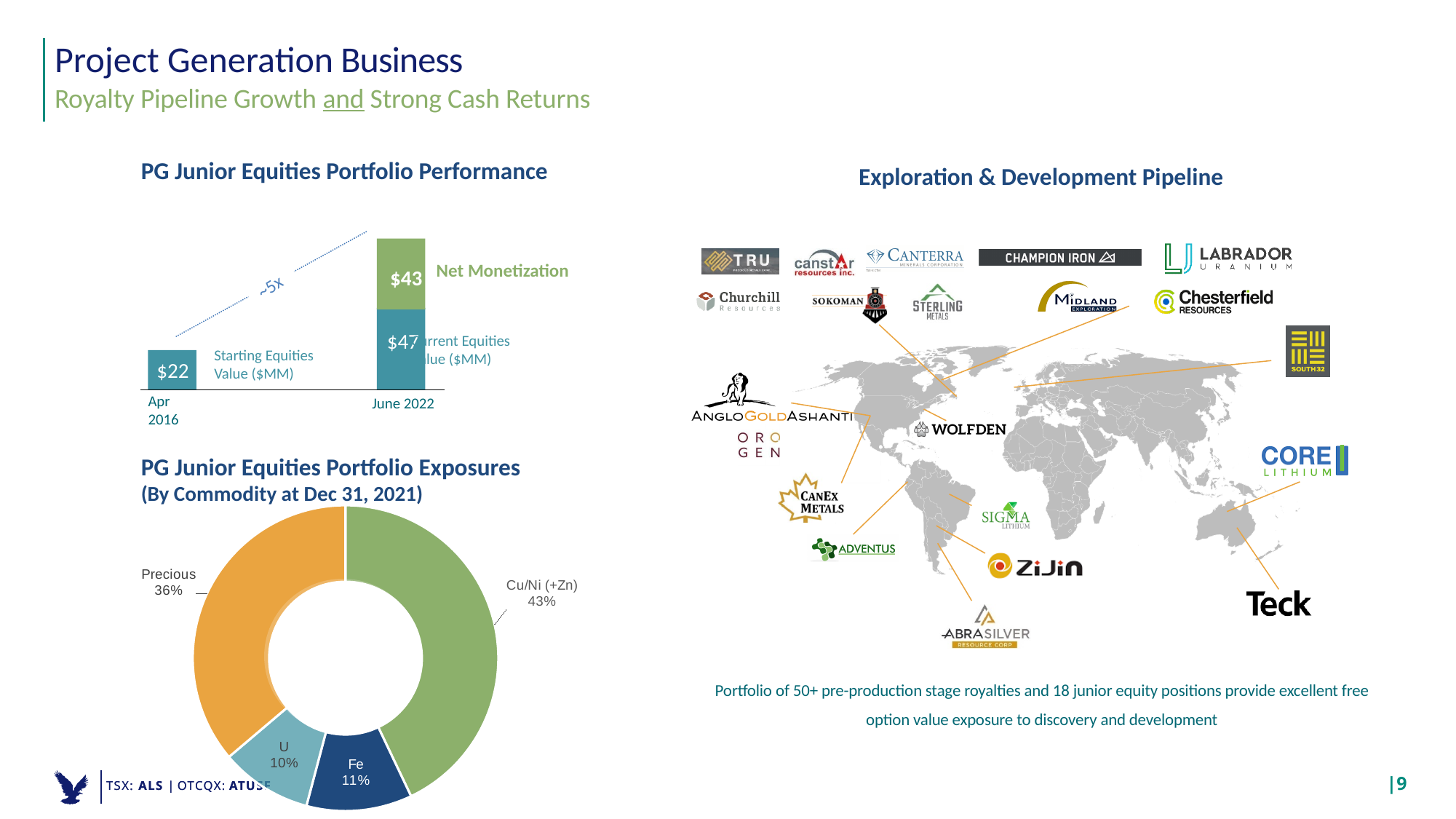
In the PG Junior Equities Portfolio Exposures chart, what is the difference between the Fe share and the U share? 1% In the PG Junior Equities Portfolio Exposures chart, what share does Cu/Ni (+Zn) have? 43% In the PG Junior Equities Portfolio Performance chart, what is the Current Equities Value for June 2022? $47 In the PG Junior Equities Portfolio Performance chart, what approximate multiple is annotated along the dotted line between the two bars? ~5x In the PG Junior Equities Portfolio Performance chart, what is the Starting Equities Value for Apr 2016? $22 In the PG Junior Equities Portfolio Exposures chart, what share does Precious have? 36% In the PG Junior Equities Portfolio Performance chart, what is the total of the stacked June 2022 bar? $90 In the PG Junior Equities Portfolio Performance chart, what is the difference between the June 2022 Current Equities Value and the Apr 2016 Starting Equities Value? $25 What kind of chart is the PG Junior Equities Portfolio Exposures chart? Donut (pie) chart In the PG Junior Equities Portfolio Performance chart, what is the Net Monetization value shown for June 2022? $43 In the PG Junior Equities Portfolio Exposures chart, which commodity has the smallest share? U In the PG Junior Equities Portfolio Exposures chart, how many commodity categories are shown? 4